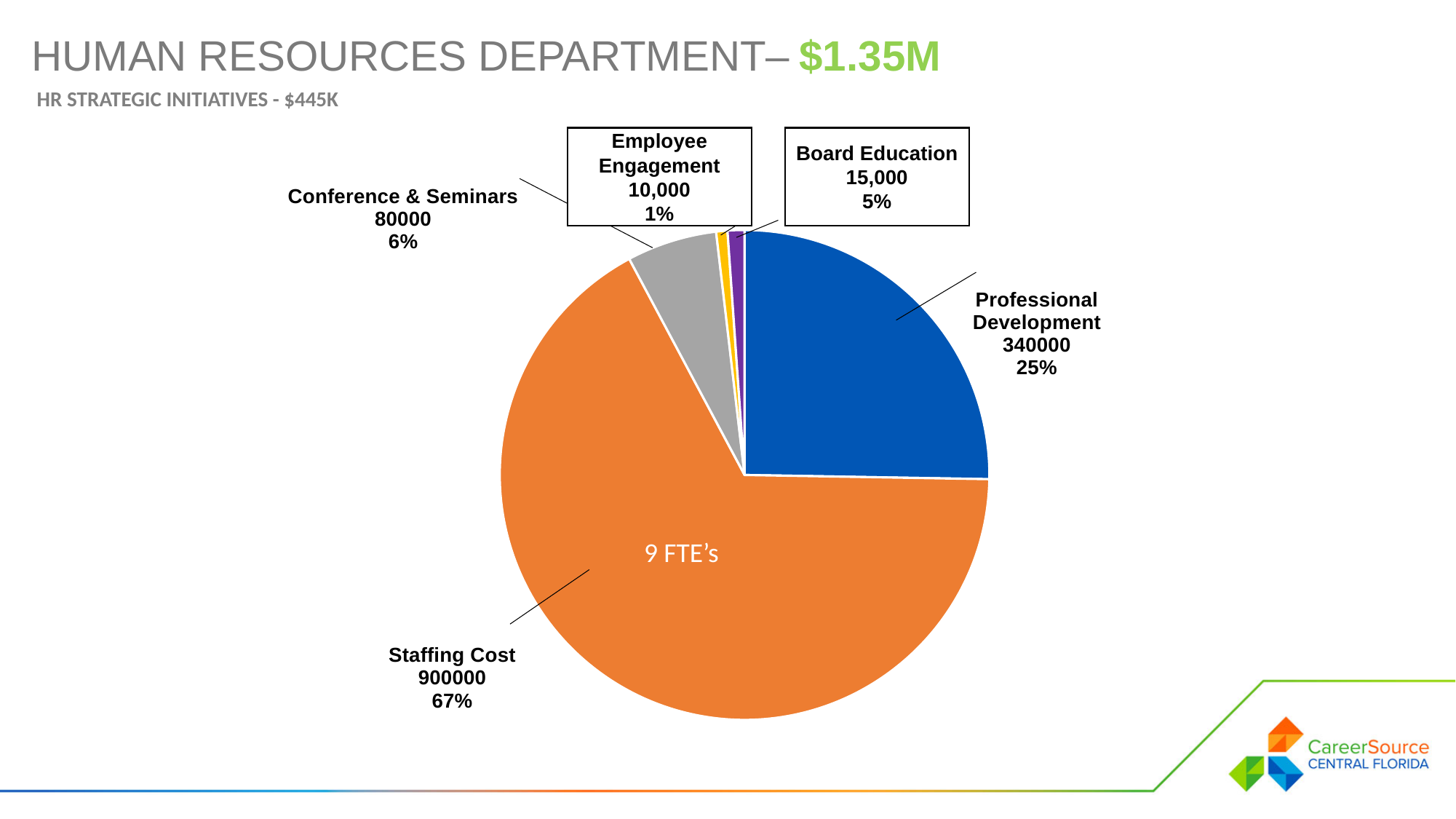
How many slices does the pie chart have? 5 What is the value shown for Professional Development? 340000 What type of chart is shown on the slide? Pie chart What text is written inside the Staffing Cost slice? 9 FTE's What percentage share does Employee Engagement have? 1% Which category has the smallest slice of the pie? Employee Engagement What is the value shown for Board Education? 15,000 What is the value shown for Staffing Cost? 900000 What is the difference between the Staffing Cost value and the Professional Development value? 560000 Which category has the largest slice of the pie? Staffing Cost Which is larger, the value for Conference & Seminars or the value for Board Education? Conference & Seminars What percentage share does Conference & Seminars have? 6%